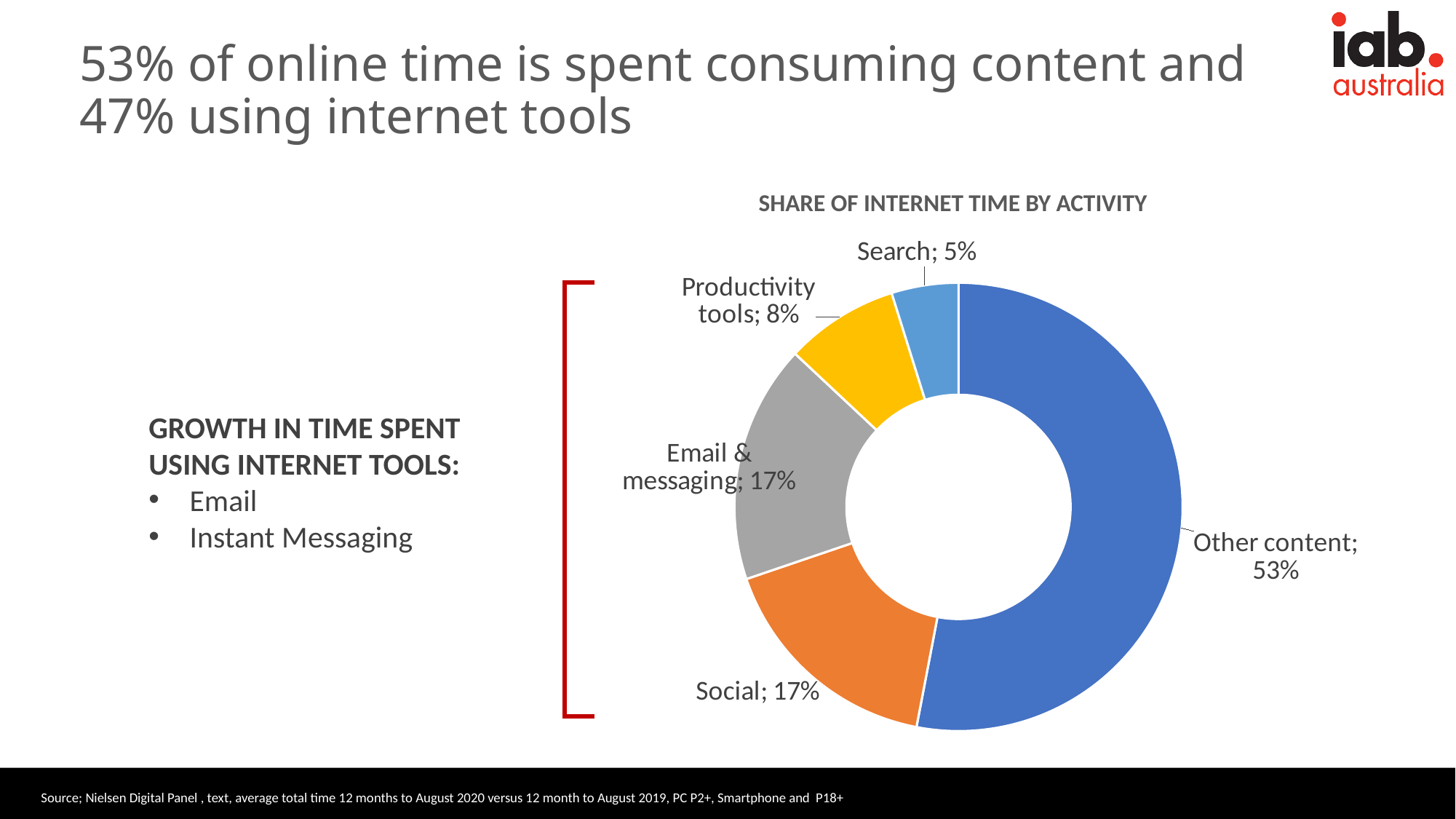
What kind of chart is shown on the slide? Doughnut (pie) chart What share of internet time is spent on Email & messaging? 17% What share of internet time is spent on Other content? 53% What is the difference in share between Other content and Social? 36% How many activity categories are shown in the chart? 5 What share of internet time is spent on Search? 5% Which activity has the smallest share of internet time? Search What is the title of the chart? SHARE OF INTERNET TIME BY ACTIVITY Which activity has the largest share of internet time? Other content Which has a larger share of internet time, Productivity tools or Search? Productivity tools What colour is the Social slice in the chart? Orange What share of internet time is spent on Productivity tools? 8%